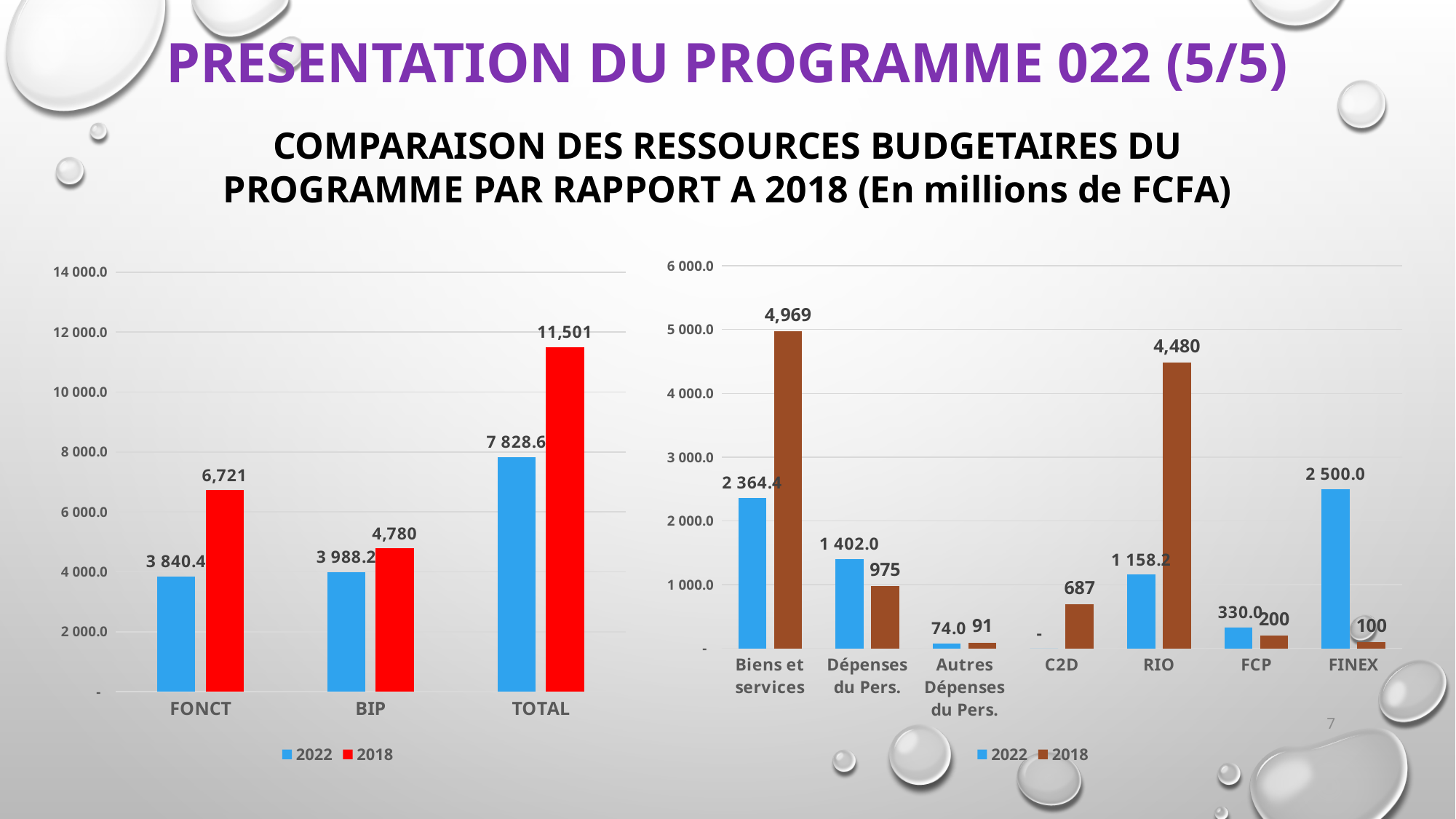
In the left chart, what is the 2018 value for TOTAL? 11,501 In the right chart, which is larger for FCP: the 2022 value or the 2018 value? 2022 In the left chart, what is the difference between the 2018 and 2022 values for BIP? 791.8 In the right chart, what is the 2018 value for RIO? 4,480 In the left chart, how many series does the legend list? 2 What kind of chart is the right chart? Bar chart In the right chart, how many categories are shown on the x axis? 7 In the left chart, what is the 2022 value for FONCT? 3 840.4 In the left chart, which category has the highest 2022 value? TOTAL In the right chart, which category has the highest 2018 value? Biens et services In the right chart, what is the 2022 value for FINEX? 2 500.0 In the right chart, which category has the lowest 2018 value? Autres Dépenses du Pers.